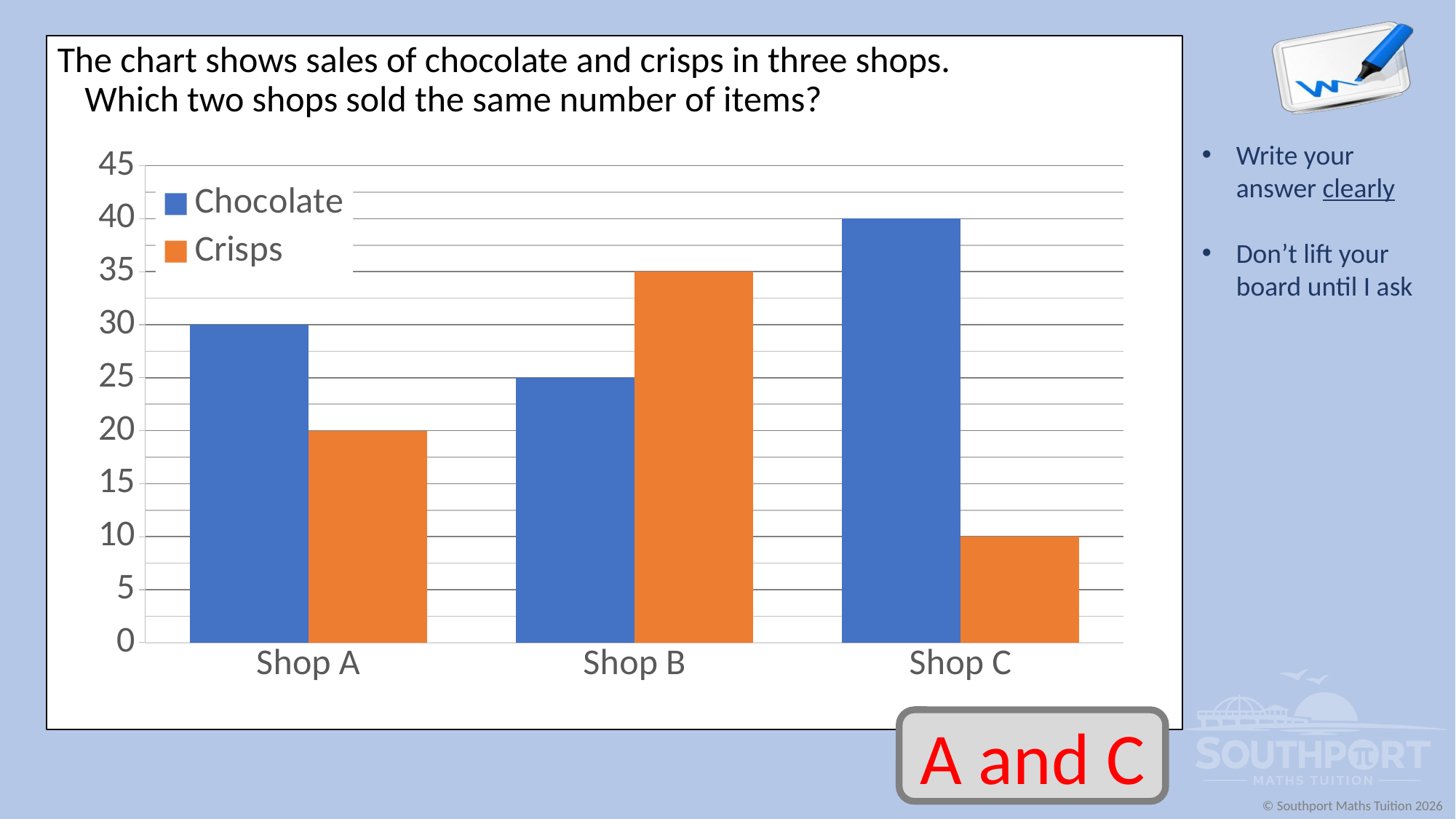
Which shop has the highest Chocolate value? Shop C How many series does the legend list? 2 What kind of chart is shown on the slide? bar chart What is the Chocolate value for Shop C? 40 What is the difference between the Chocolate and Crisps values for Shop A? 10 What is the Crisps value for Shop C? 10 Which series is shown in orange in the legend? Crisps What is the Chocolate value for Shop A? 30 For Shop B, which is larger, Chocolate or Crisps? Crisps Which shop has the lowest Crisps value? Shop C What is the Crisps value for Shop B? 35 How many shops are shown on the x axis? 3